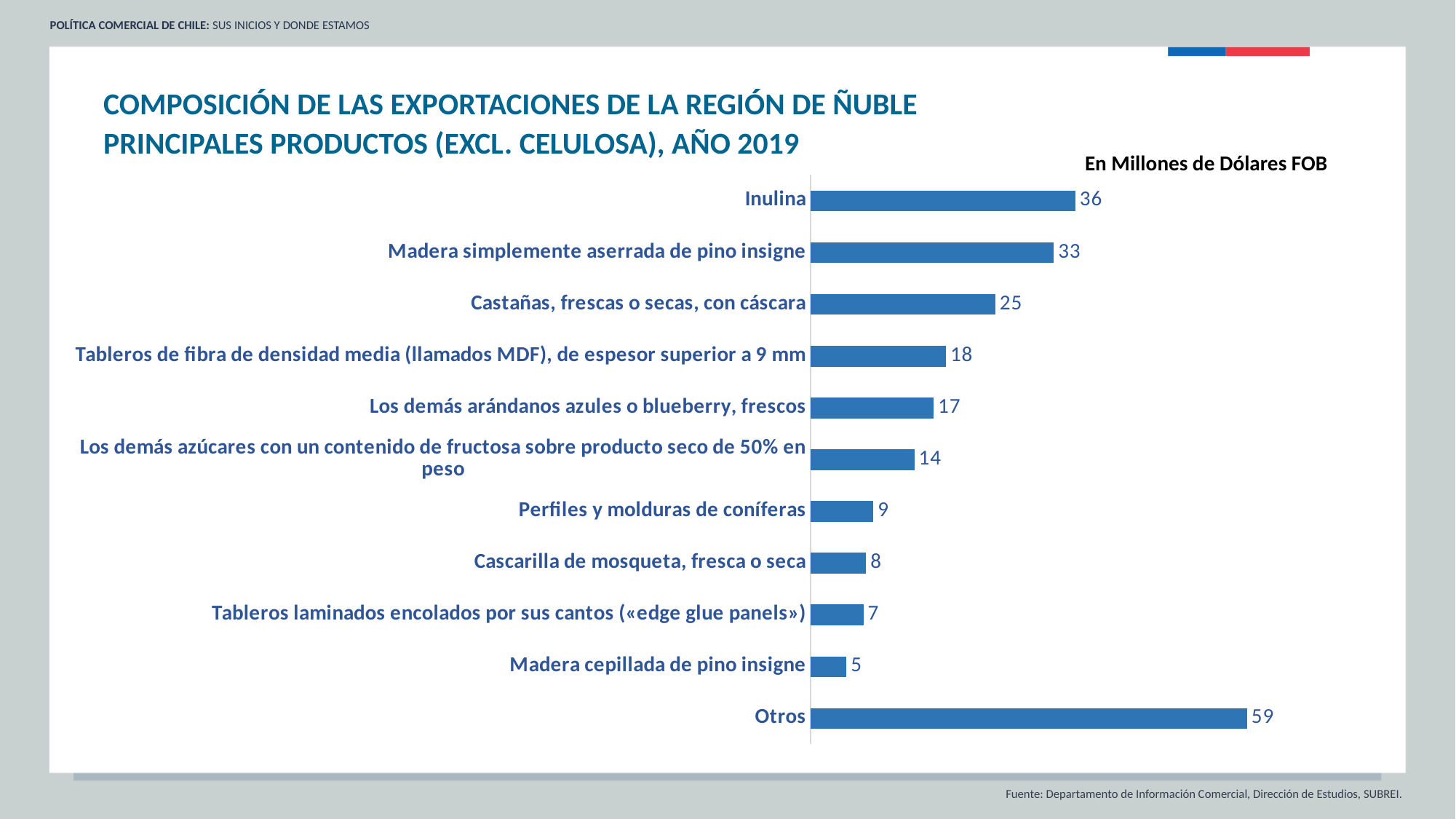
What is the difference between the values for Inulina and Madera simplemente aserrada de pino insigne? 3 What is the value for Otros? 59 How many categories are shown in the chart? 11 Which category has the highest value? Otros What is the value for Madera cepillada de pino insigne? 5 Which category has the lowest value? Madera cepillada de pino insigne What is the value for Castañas, frescas o secas, con cáscara? 25 Which is larger: the value for Perfiles y molduras de conÍferas or the value for Cascarilla de mosqueta, fresca o seca? Perfiles y molduras de coníferas What is the value for Inulina? 36 What unit are the values expressed in, according to the label above the chart? En Millones de Dólares FOB What kind of chart is shown on the slide? Bar chart What is the value for Los demás arándanos azules o blueberry, frescos? 17